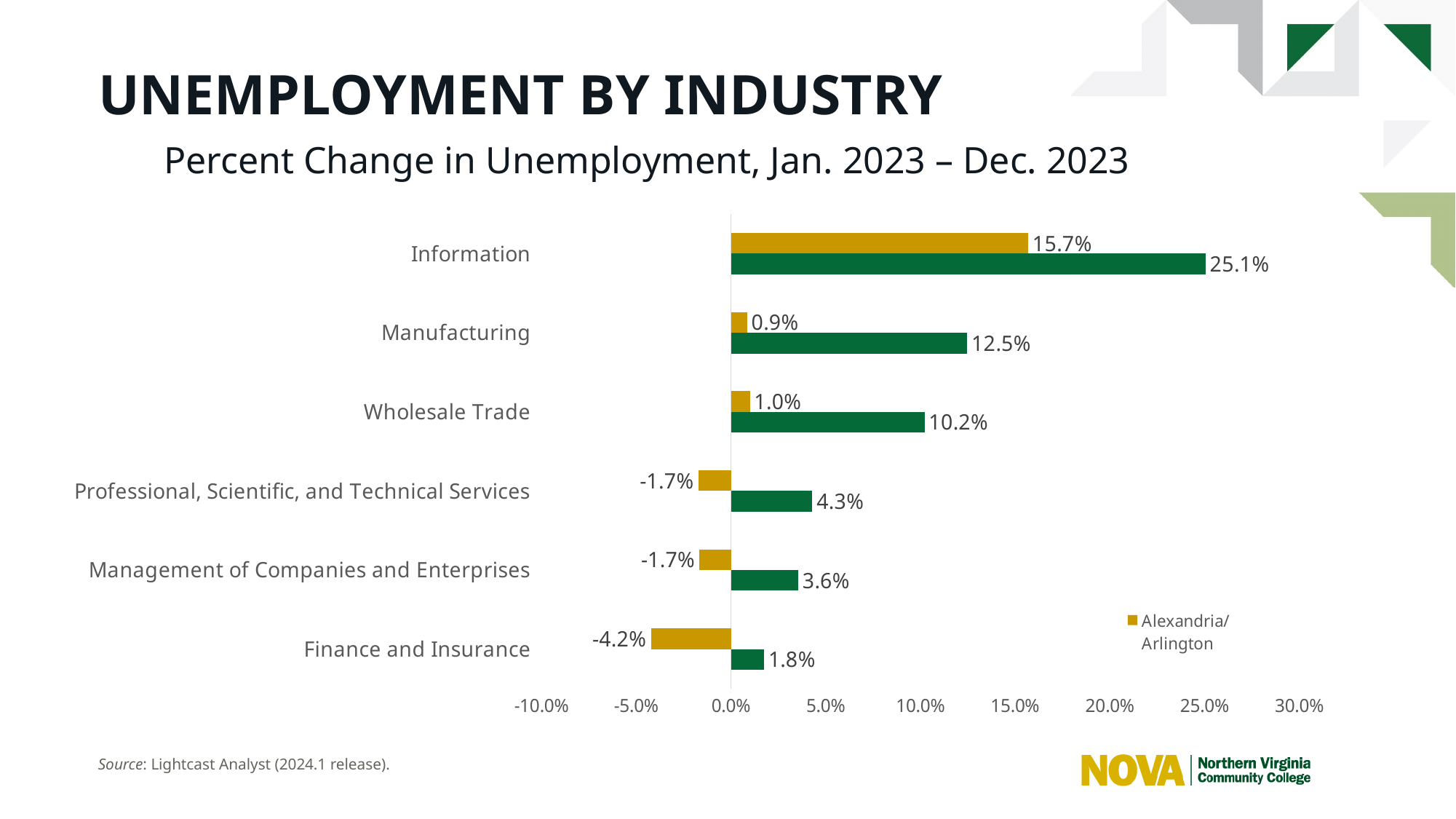
Which industry has the lowest Alexandria/Arlington value? Finance and Insurance Which industry has the lowest value for the green series? Finance and Insurance How many industries are shown on the chart? 6 What is the chart's subtitle describing the data? Percent Change in Unemployment, Jan. 2023 – Dec. 2023 What type of chart is shown on the slide? bar chart What is the value for Alexandria/Arlington in the Information category? 15.7% What is the Alexandria/Arlington value for Finance and Insurance? -4.2% What is the difference between the green bar and the Alexandria/Arlington bar for Information? 9.4% Which industry has the highest Alexandria/Arlington value? Information What is the value of the green bar for Manufacturing? 12.5% Which is larger for Manufacturing: the Alexandria/Arlington value or the green bar value? the green bar value What is the value of the green bar for Wholesale Trade? 10.2%